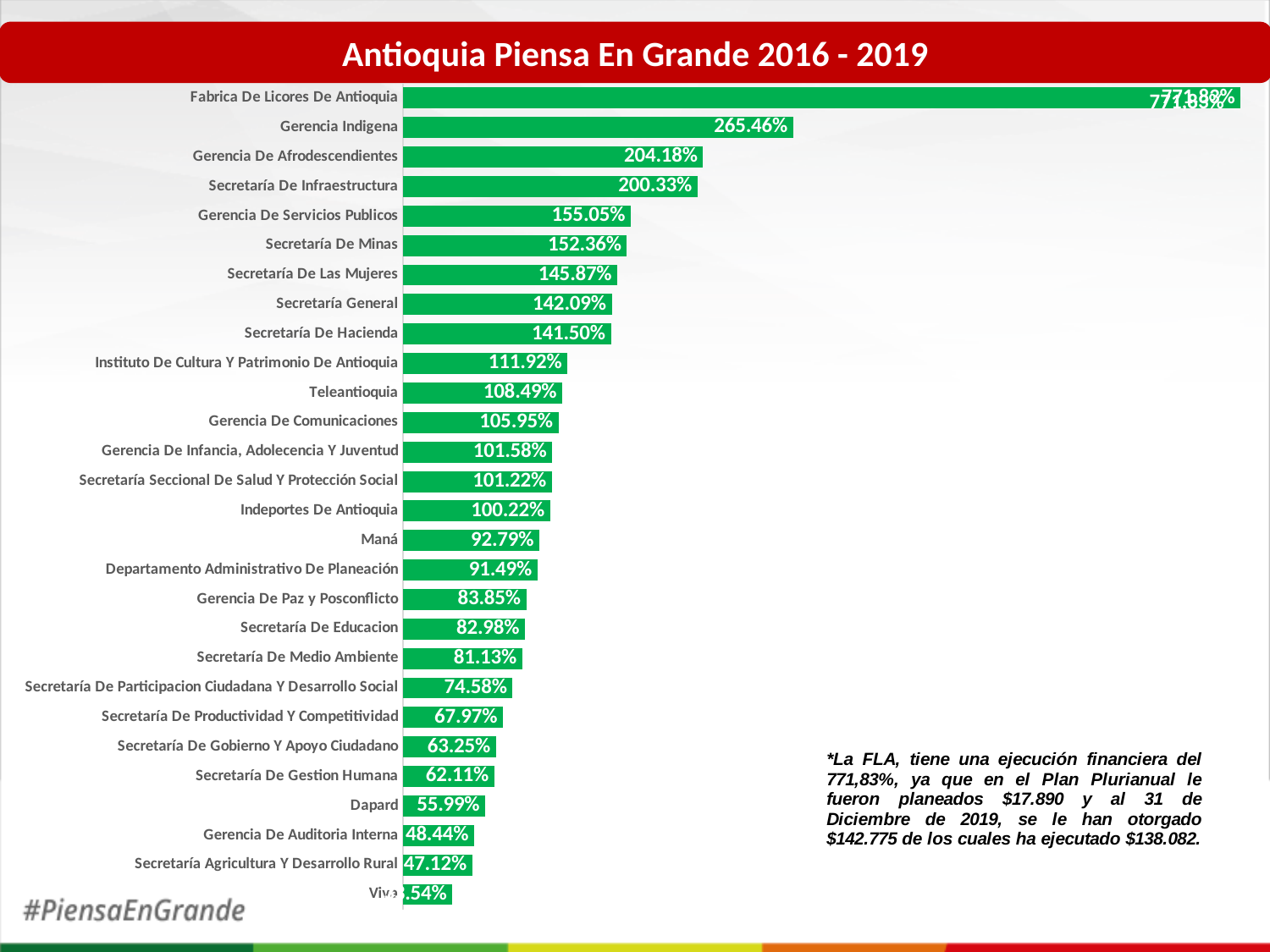
What is the value for Dapard? 55.99% Which category has the highest value? Fabrica De Licores De Antioquia What is the difference between the values for Secretaría De Educacion and Secretaría De Medio Ambiente? 1.85% What is the difference between the values for Gerencia Indigena and Gerencia De Afrodescendientes? 61.28% What is the value for Teleantioquia? 108.49% What is the value for Gerencia Indigena? 265.46% Which is larger, the value for Secretaría De Minas or the value for Secretaría De Las Mujeres? Secretaría De Minas What is the title of the chart? Antioquia Piensa En Grande 2016 - 2019 Which category has the lowest value? Viva What kind of chart is shown on the slide? Bar chart What is the value for Secretaría De Hacienda? 141.50% Do the values rise or fall going from the top bar to the bottom bar? Fall